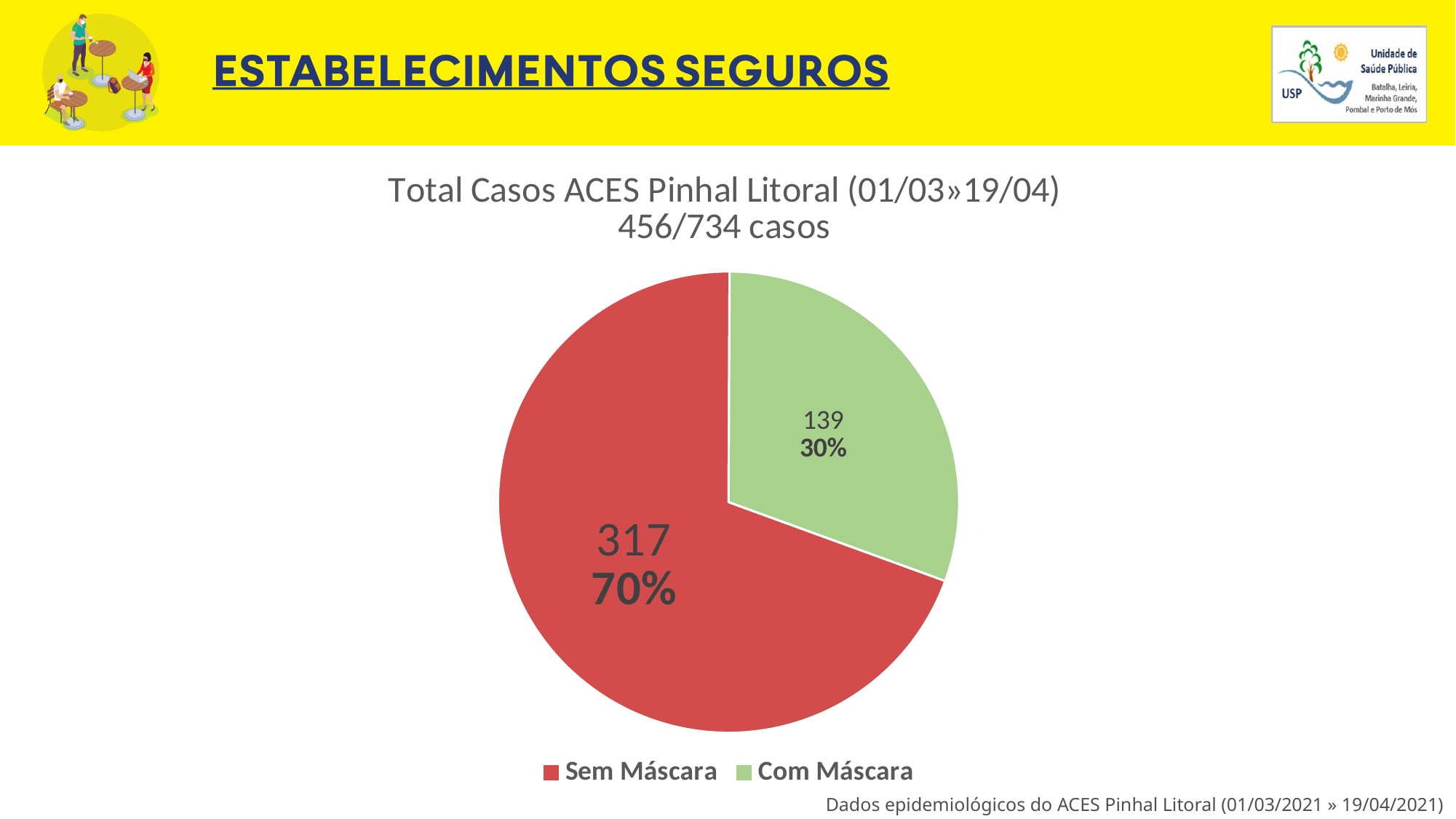
What is the value for Com Máscara? 139 What is the title of the chart? Total Casos ACES Pinhal Litoral (01/03»19/04) 456/734 casos Which category has the largest slice? Sem Máscara What percentage share does the Com Máscara slice represent? 30% What percentage share does the Sem Máscara slice represent? 70% Which is larger, the value for Sem Máscara or Com Máscara? Sem Máscara What type of chart is shown on the slide? pie chart How many slices does the pie chart have? 2 What is the value for Sem Máscara? 317 Which category has the smallest slice? Com Máscara What is the difference between the Sem Máscara and Com Máscara values? 178 What colour is the Com Máscara slice? green